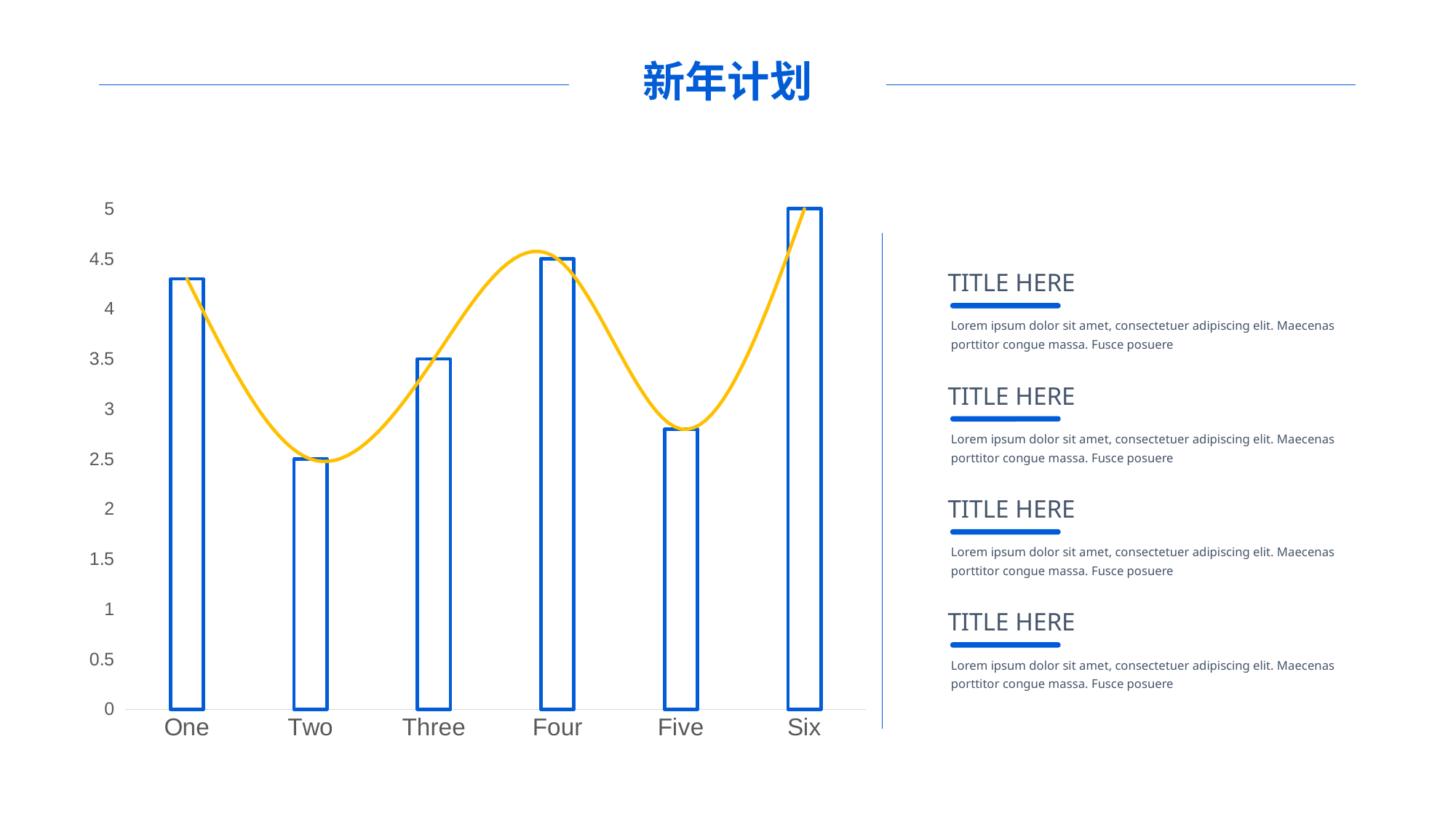
Is the value for Five greater or less than 3? less Which category has the highest bar? Six What is the value of the bar for Two? 2.5 What is the difference between the bars for Four and Two? 2 What is the value of the bar for Three? 3.5 What is the title of the slide above the chart? 新年计划 Is the value for One greater or less than 4? greater Which bar is taller, Three or Four? Four Which category has the lowest bar? Two What is the value of the bar for Six? 5 How many categories are shown on the x axis? 6 What is the value of the bar for Four? 4.5